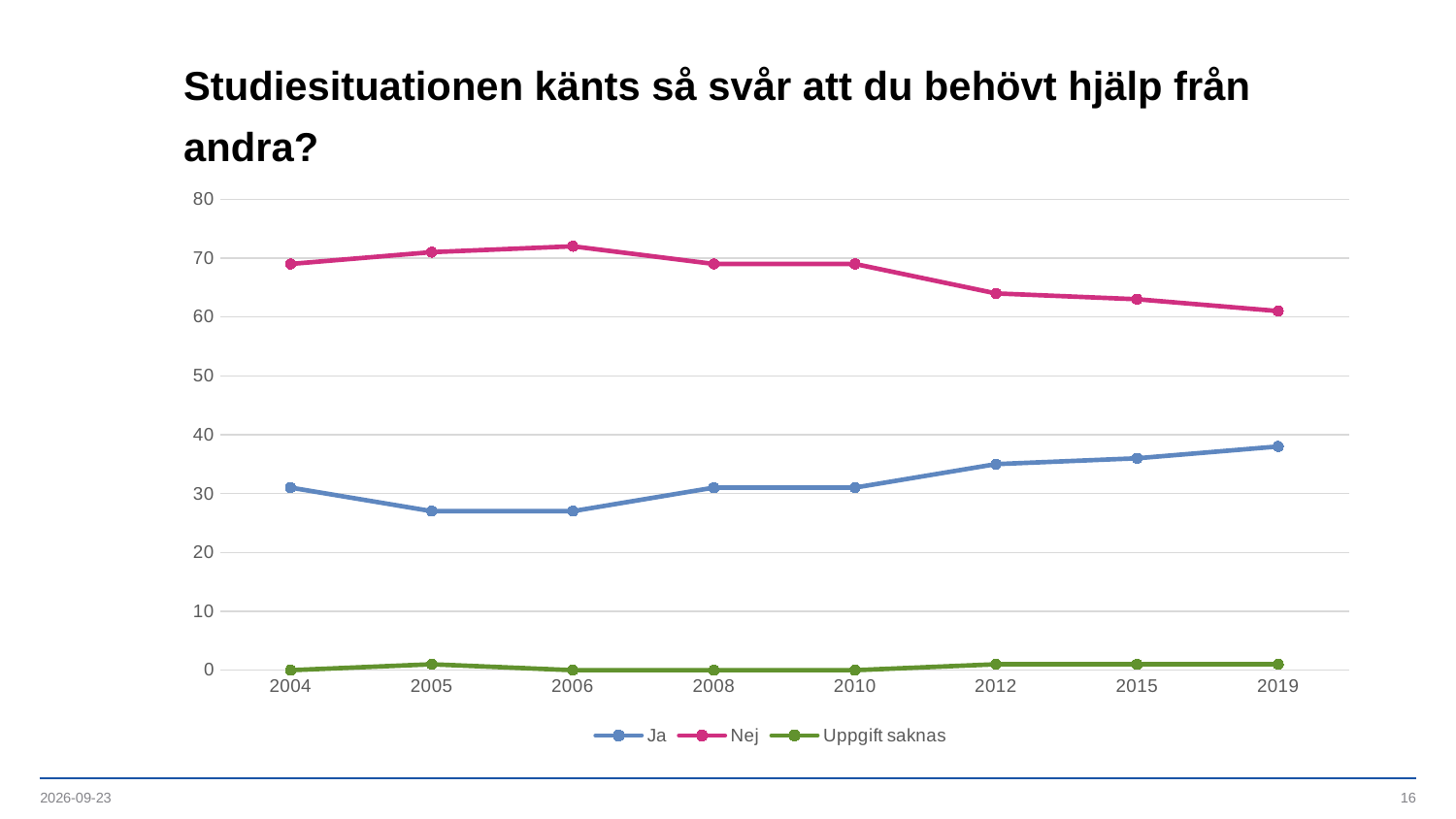
Does the Nej series rise or fall between 2006 and 2019? fall How many series does the legend list? 3 Is the value for Nej in 2004 greater or less than 60? greater Which series has the highest values across all years, Ja or Nej? Nej How many years are shown on the x axis? 8 In which year is the Ja series at its highest? 2019 Does the Ja series rise or fall between 2006 and 2019? rise Is the value for Ja in 2012 greater or less than 30? greater What kind of chart is shown on the slide? line chart Which series is drawn in green? Uppgift saknas Is the value for Ja in 2005 greater or less than 30? less In which year is the Nej series at its lowest? 2019